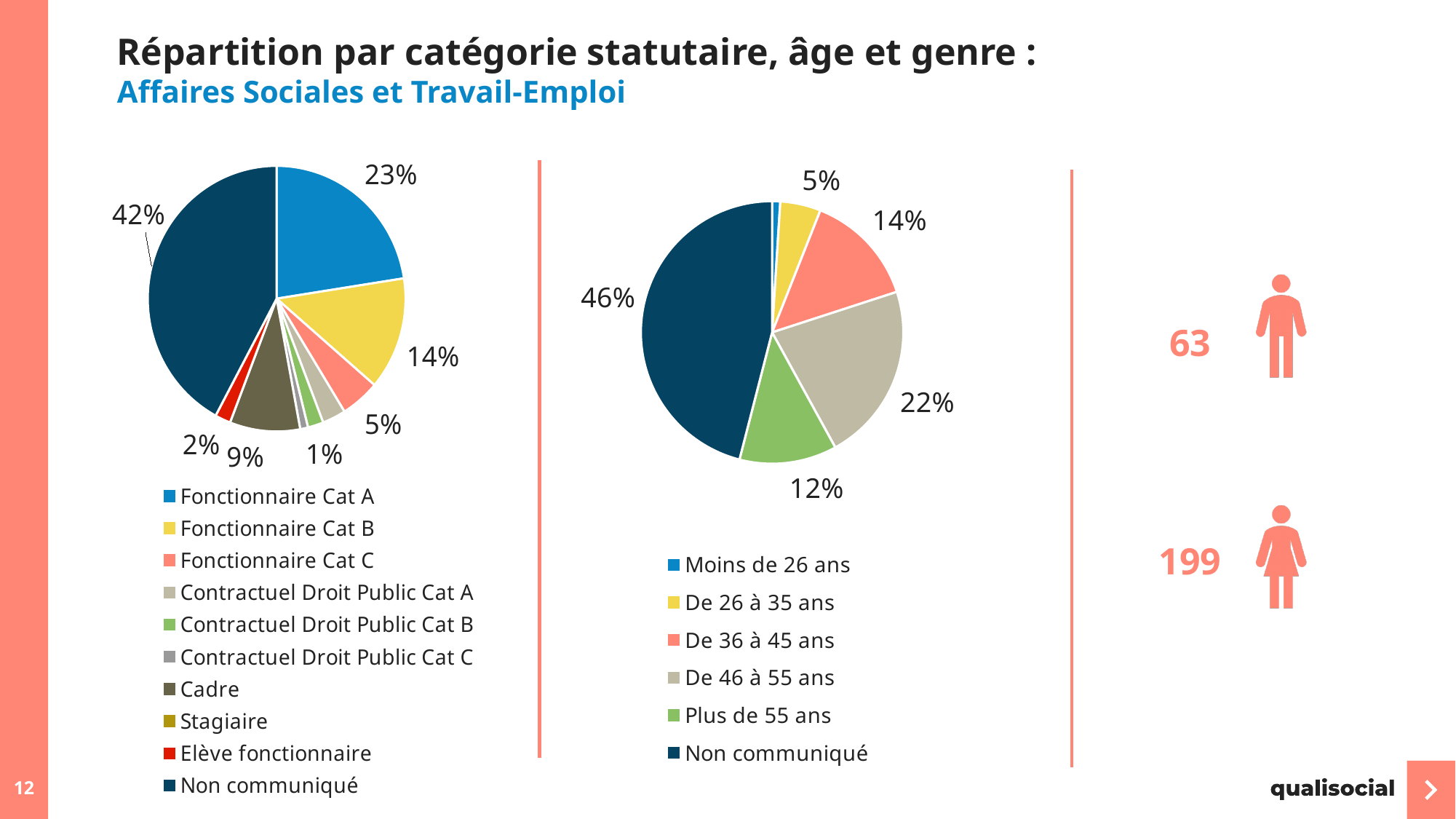
In the right pie chart (age), what share is De 46 à 55 ans? 22% In the left pie chart (statutory category), what share is Fonctionnaire Cat A? 23% In the left pie chart (statutory category), what is the difference between Fonctionnaire Cat A and Fonctionnaire Cat B? 9% In the right pie chart (age), what share is Plus de 55 ans? 12% In the right pie chart (age), which is larger: De 36 à 45 ans or De 26 à 35 ans? De 36 à 45 ans In the left pie chart (statutory category), what share is Non communiqué? 42% In the left pie chart (statutory category), what share is Elève fonctionnaire? 2% What type of chart is used on this slide? Pie chart In the left pie chart (statutory category), which category has the largest slice? Non communiqué In the left pie chart (statutory category), what share is Cadre? 9% In the left pie chart (statutory category), how many entries does the legend list? 10 In the right pie chart (age), which category has the largest slice? Non communiqué